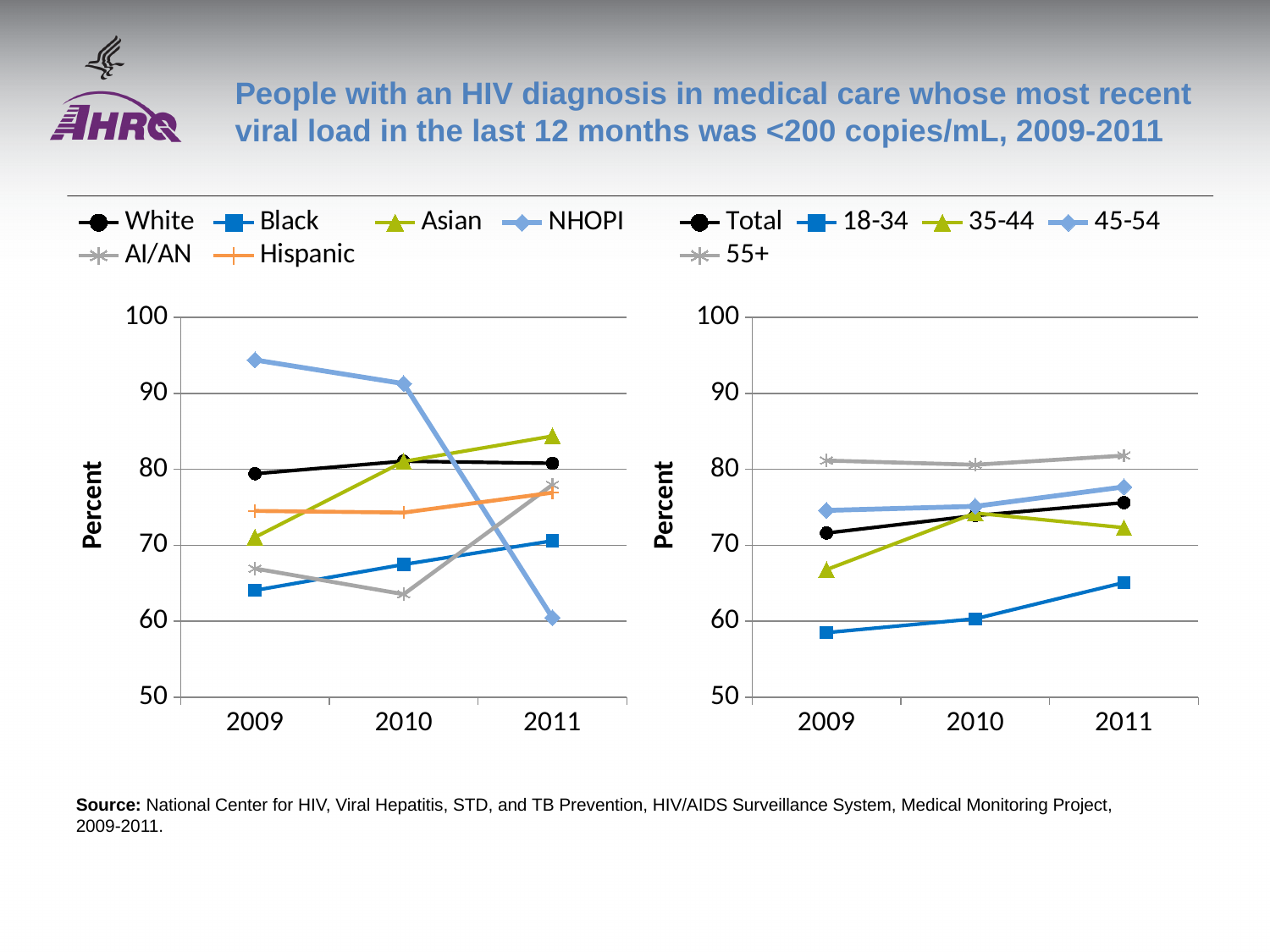
In the left chart, is the value for NHOPI in 2009 greater or less than 90? greater What is the label on the y axis of the right chart? Percent In the left chart, does the NHOPI line rise or fall from 2009 to 2011? Fall In the left chart, which group has the highest value in 2009? NHOPI In the left chart, which group has the lowest value in 2009? Black In the right chart, which is larger in 2011: the value for 55+ or the value for 18-34? 55+ In the right chart, does the 18-34 line rise or fall from 2009 to 2011? Rise How many series does the legend of the right chart list? 5 How many years are shown on the x axis of the right chart? 3 How many series does the legend of the left chart list? 6 What kind of chart is the left chart on the slide? Line chart In the right chart, is the value for 18-34 in 2009 greater or less than 60? less